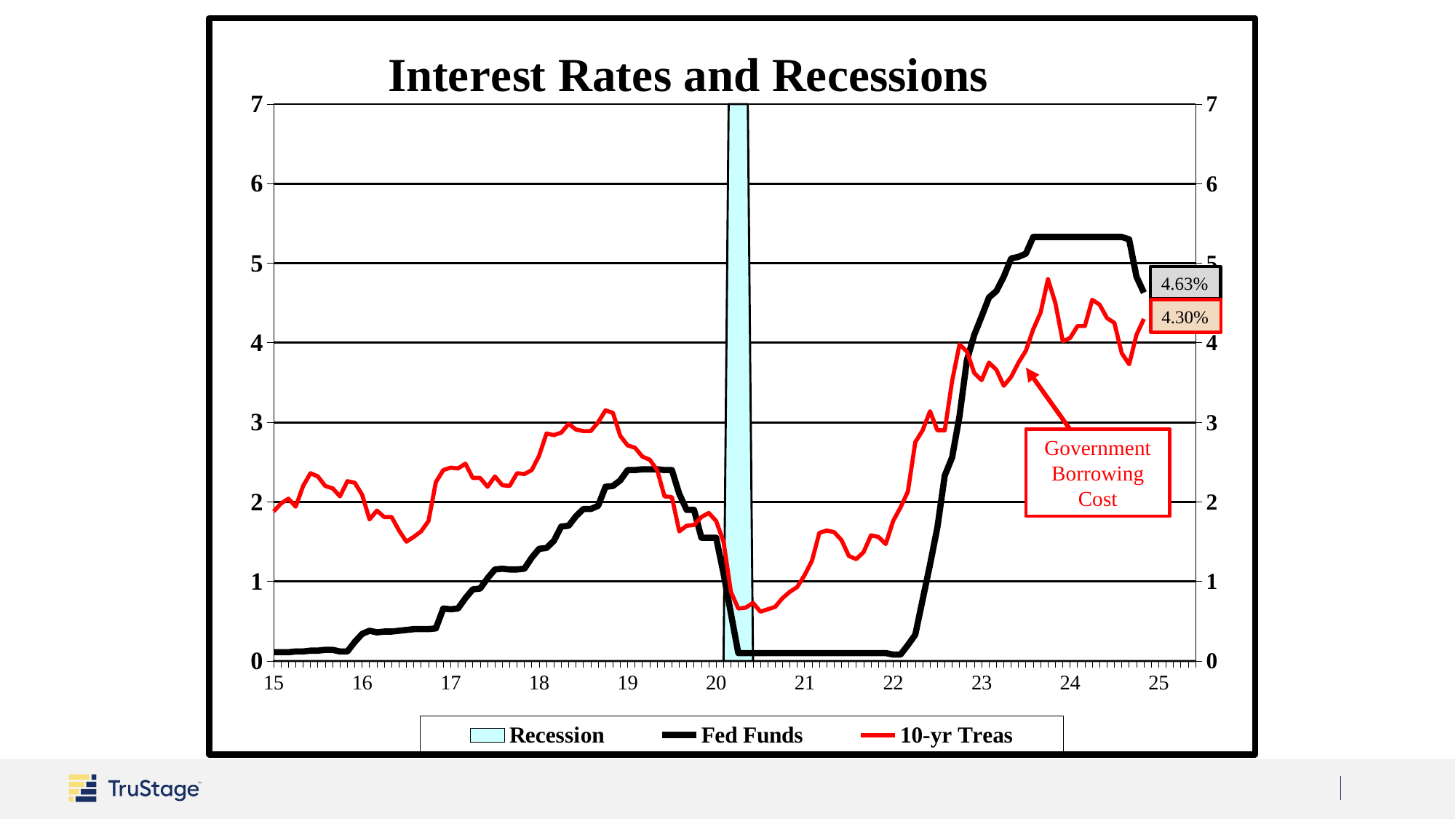
Is the 10-yr Treas value during 2016 greater or less than 3? less Is the Fed Funds value during 2021 greater or less than 1? less What is the latest labelled value for the Fed Funds series? 4.63% Which series does the 'Government Borrowing Cost' annotation point to? 10-yr Treas What is the title of the chart? Interest Rates and Recessions Does the Fed Funds series rise or fall between 2022 and 2023? rise What is the difference between the latest labelled Fed Funds value (4.63%) and the latest labelled 10-yr Treas value (4.30%)? 0.33% At the end of the chart, which series has the higher labelled value, Fed Funds or 10-yr Treas? Fed Funds What is the latest labelled value for the 10-yr Treas series? 4.30% How many entries does the chart's legend list? 3 What kind of chart is shown on the slide? line chart Is the peak Fed Funds value reached around 2023-24 greater or less than 5? greater